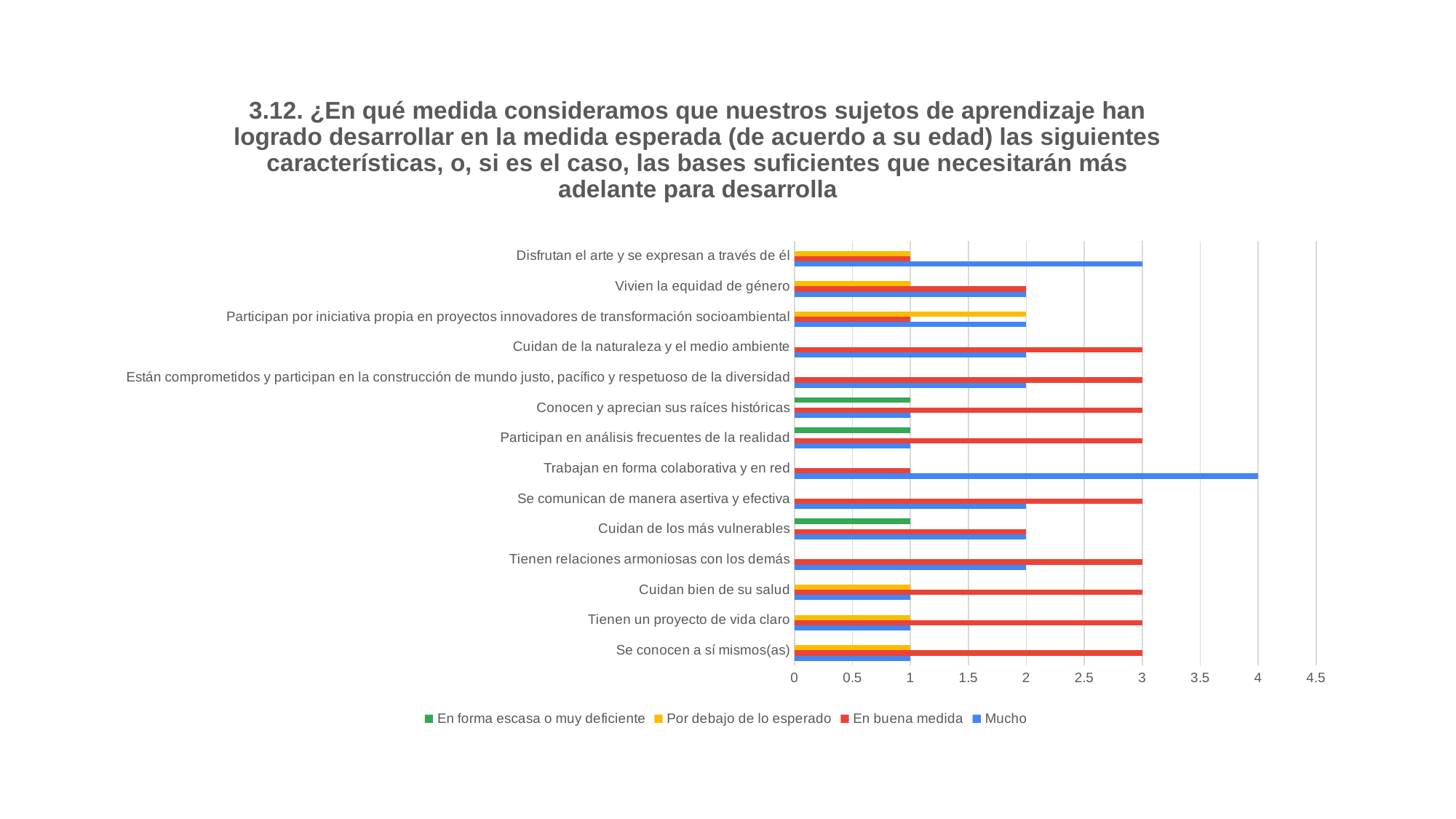
Which category has the highest value for the 'Mucho' series? Trabajan en forma colaborativa y en red What is the value of the 'Mucho' series for 'Trabajan en forma colaborativa y en red'? 4 Is the 'Mucho' value for 'Trabajan en forma colaborativa y en red' greater or less than 3.5? greater For 'Se comunican de manera asertiva y efectiva', which is larger: the 'En buena medida' value or the 'Mucho' value? En buena medida What is the value of the 'En buena medida' series for 'Cuidan de la naturaleza y el medio ambiente'? 3 For 'Trabajan en forma colaborativa y en red', what is the difference between the 'Mucho' value and the 'En buena medida' value? 3 How many categories are plotted on the chart? 14 What is the value of the 'Mucho' series for 'Disfrutan el arte y se expresan a través de él'? 3 How many series does the legend list? 4 What kind of chart is shown on the slide? Bar chart Which legend entry is shown in green? En forma escasa o muy deficiente What is the value of the 'Por debajo de lo esperado' series for 'Participan por iniciativa propia en proyectos innovadores de transformación socioambiental'? 2